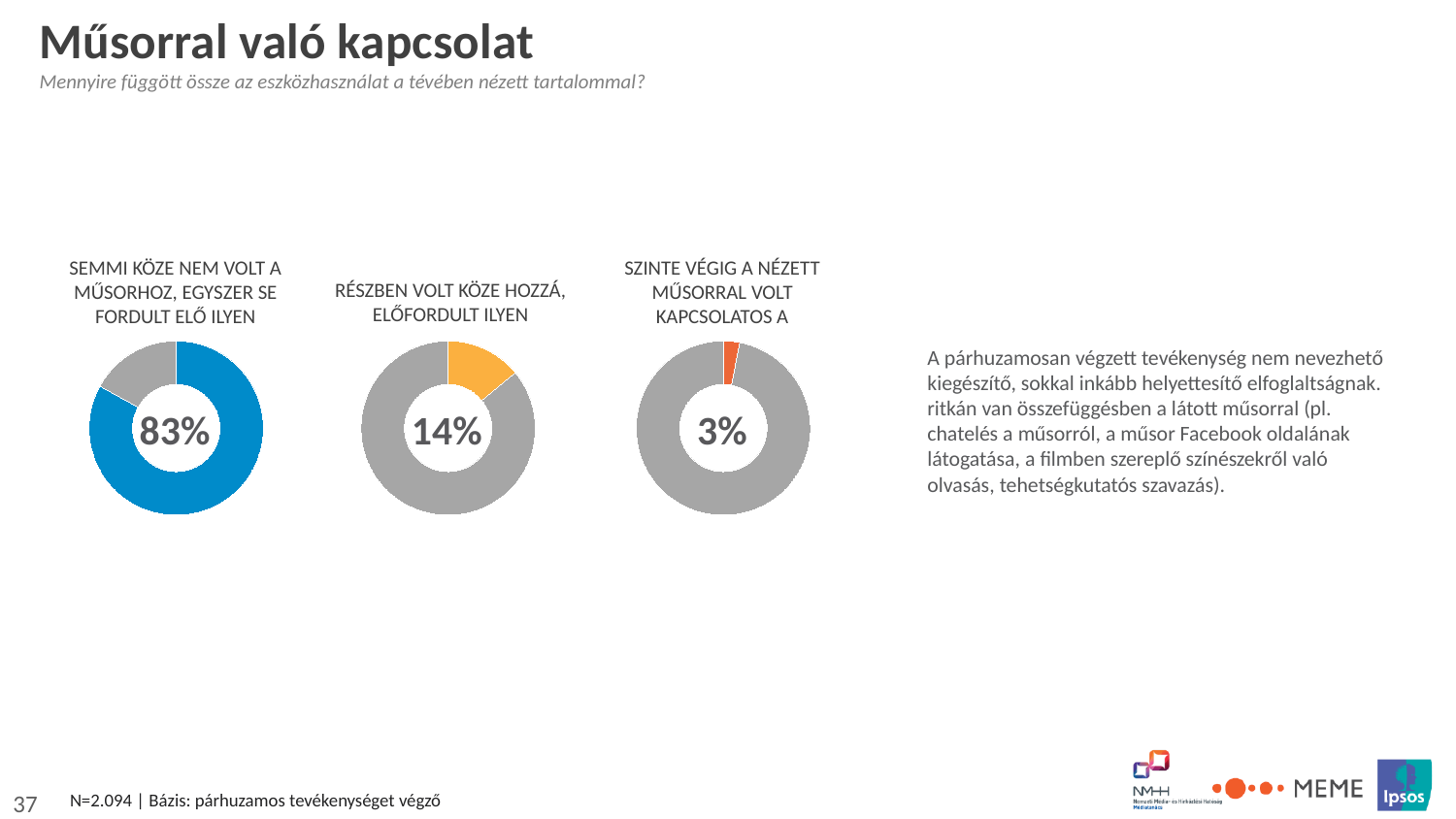
Which is larger: the value in the middle donut chart or the value in the right donut chart? The middle donut chart (14%) What value is shown in the right donut chart, labelled 'Szinte végig a nézett műsorral volt kapcsolatos a'? 3% What colour is the highlighted segment in the left donut chart showing 83%? Blue What value is shown in the middle donut chart, labelled 'Részben volt köze hozzá, előfordult ilyen'? 14% What value is shown in the left donut chart, labelled 'Semmi köze nem volt a műsorhoz, egyszer se fordult elő ilyen'? 83% How many donut charts are shown on the slide? 3 What is the difference between the value in the left donut chart (83%) and the value in the middle donut chart (14%)? 69 percentage points Which of the three donut charts shows the highest value? Semmi köze nem volt a műsorhoz, egyszer se fordult elő ilyen (83%) Which of the three donut charts shows the lowest value? Szinte végig a nézett műsorral volt kapcsolatos a (3%) What is the total of the three percentages shown in the donut charts (83%, 14%, 3%)? 100% What type of chart is used to display the three percentages on the slide? Donut (pie) chart What is the difference between the value in the middle donut chart (14%) and the value in the right donut chart (3%)? 11 percentage points